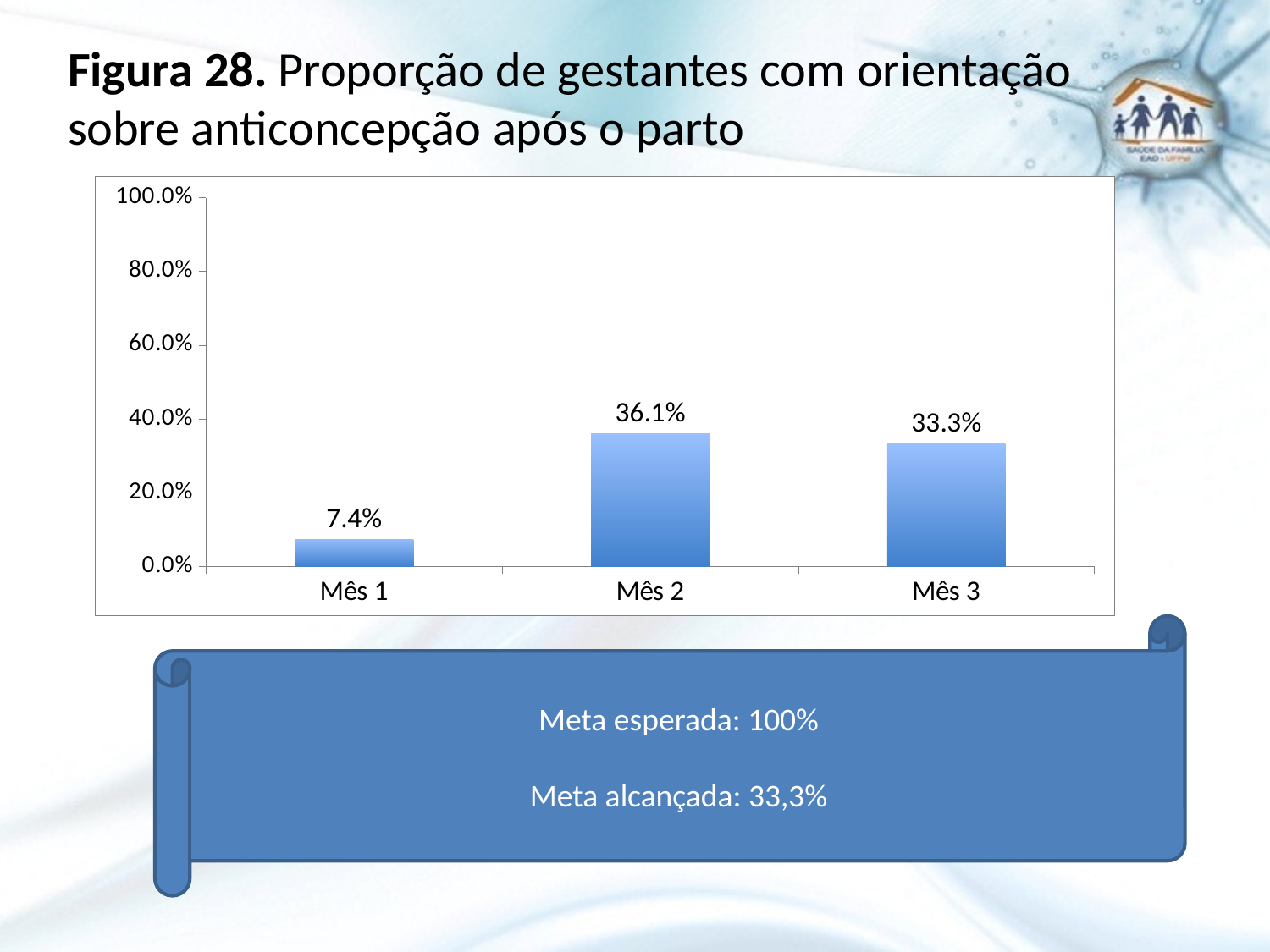
What is the highest value shown on the y axis? 100.0% What is the value for Mês 1? 7.4% How many months are shown on the x axis? 3 Which month has the highest value? Mês 2 Is the value for Mês 2 greater or less than 20.0%? greater Which is larger, the value for Mês 1 or the value for Mês 3? Mês 3 What is the value for Mês 2? 36.1% Which month has the lowest value? Mês 1 What is the difference between the values for Mês 2 and Mês 1? 28.7% What is the value for Mês 3? 33.3% What kind of chart is shown on the slide? Bar chart What is the difference between the values for Mês 2 and Mês 3? 2.8%